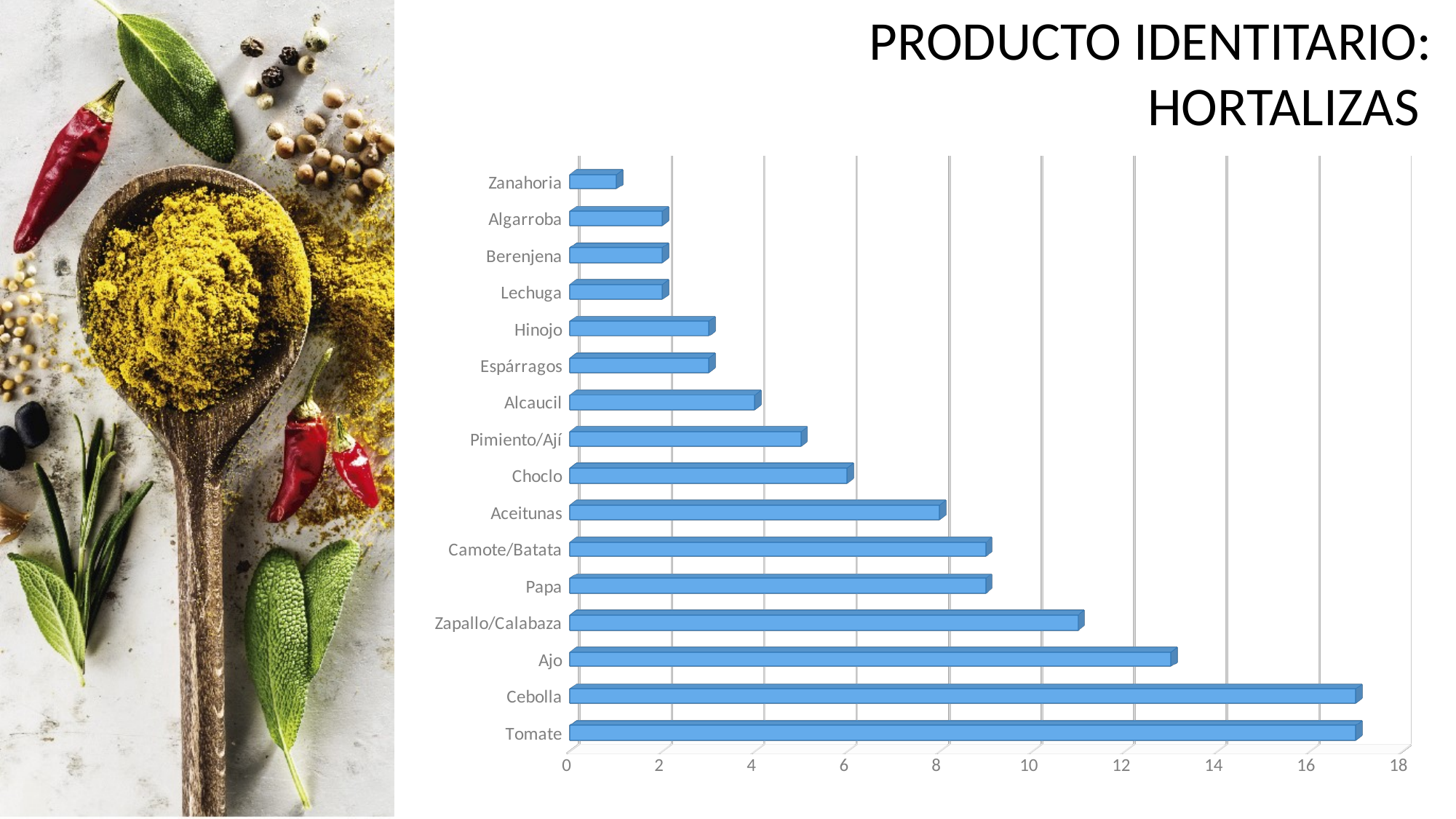
Is the value for Zapallo/Calabaza greater or less than 10? greater Is the value for Ajo greater or less than 12? greater What is the title shown on the slide above the chart? PRODUCTO IDENTITARIO: HORTALIZAS Is the value for Zanahoria greater or less than 2? less Which has a larger value, Ajo or Zapallo/Calabaza? Ajo What colour are the bars in the chart? blue How many categories (hortalizas) are plotted in the chart? 16 Which category has the lowest value in the chart? Zanahoria Which has a larger value, Aceitunas or Choclo? Aceitunas What kind of chart is shown on the slide? bar chart